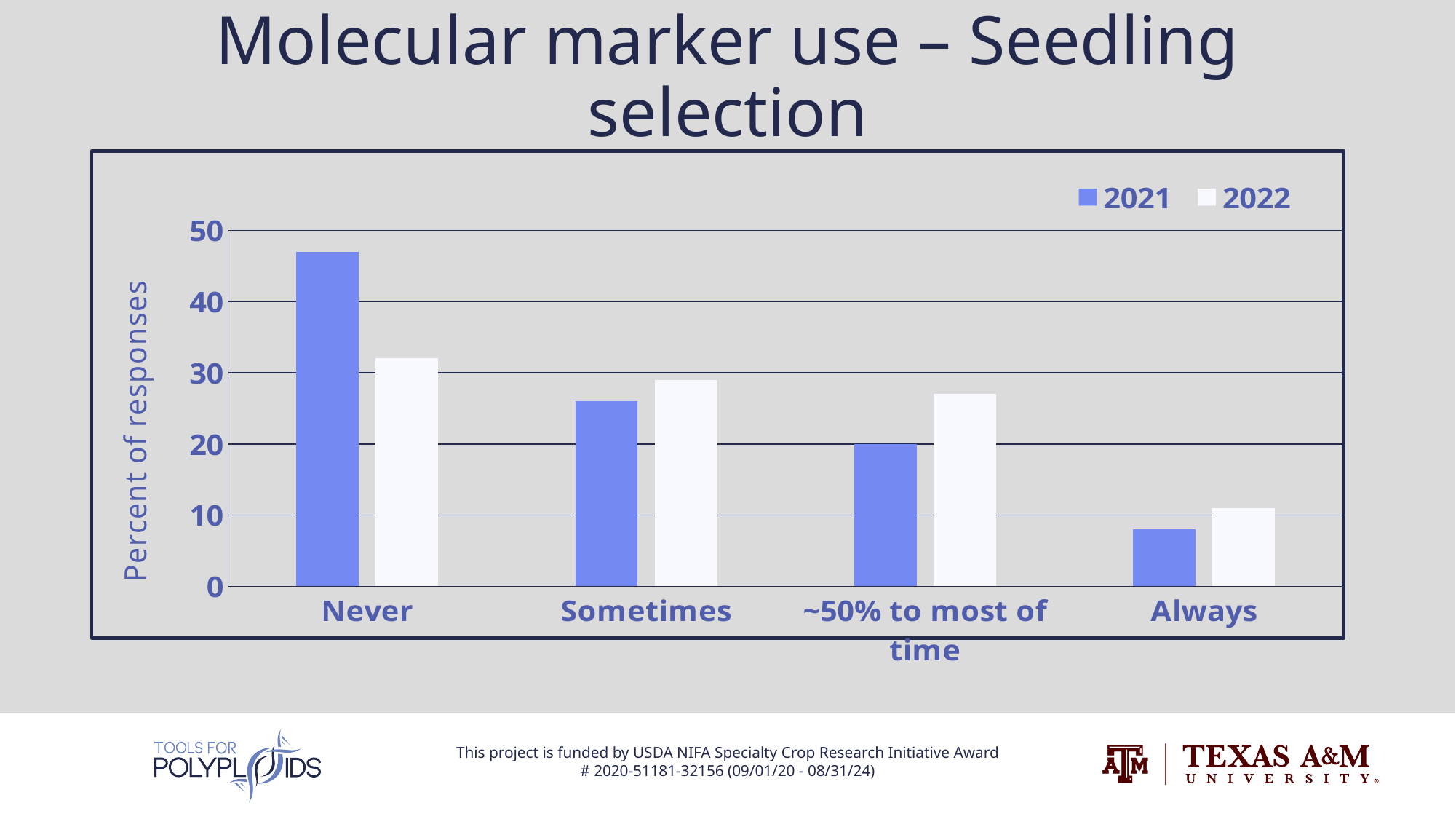
Is the 2022 value for Never greater or less than 30? greater For the Never category, which series has the larger value, 2021 or 2022? 2021 Is the 2021 value for Sometimes greater or less than 30? less Is the 2021 value for Never greater or less than 40? greater What is the title of the y axis? Percent of responses What kind of chart is shown on the slide? bar chart How many categories are shown on the x axis? 4 How many series does the legend list? 2 Which category has the lowest value for 2021? Always Which category has the highest value for 2021? Never For the Sometimes category, which series has the larger value, 2021 or 2022? 2022